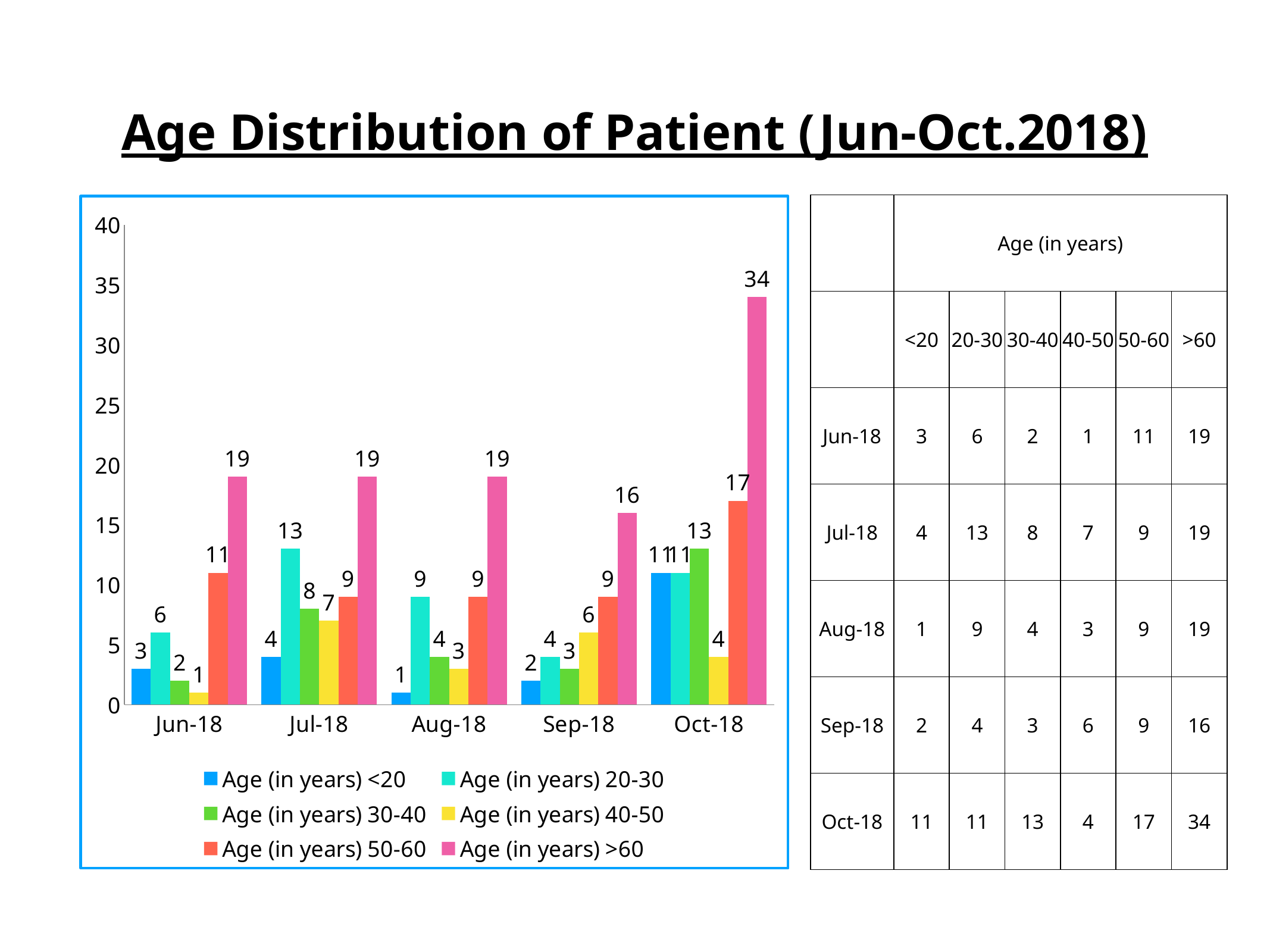
Which month has the highest value for Age (in years) >60? Oct-18 What is the value for Age (in years) >60 in Oct-18? 34 How many months are shown on the x axis? 5 What is the value for Age (in years) 20-30 in Jul-18? 13 Is the value for Age (in years) >60 in Oct-18 greater or less than 30? greater What is the value for Age (in years) 50-60 in Jun-18? 11 What is the title of the slide? Age Distribution of Patient (Jun-Oct.2018) Which is larger in Jul-18: Age (in years) 30-40 or Age (in years) 40-50? Age (in years) 30-40 Which month has the lowest value for Age (in years) <20? Aug-18 How many series does the legend list? 6 What is the difference between the Age (in years) >60 values for Oct-18 and Sep-18? 18 What kind of chart is shown? bar chart